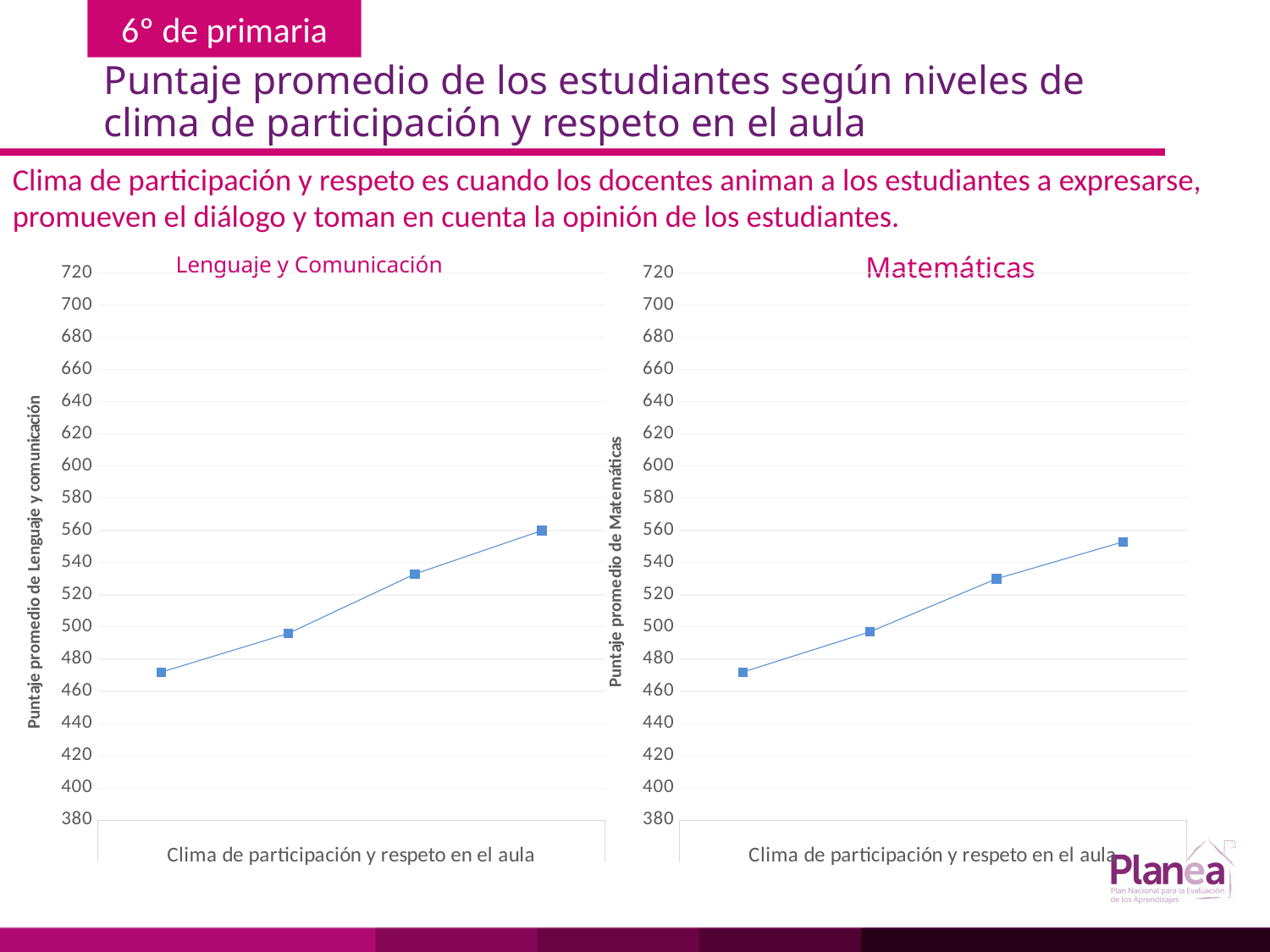
What is the y-axis title of the Lenguaje y Comunicación chart? Puntaje promedio de Lenguaje y comunicación How many data points are plotted on the Lenguaje y Comunicación chart? 4 On the Matemáticas chart, is the value of the leftmost point greater or less than 480? less What kind of chart is the Lenguaje y Comunicación chart? line chart How many data points are plotted on the Matemáticas chart? 4 On the Lenguaje y Comunicación chart, do the values rise or fall from left to right along the x axis? rise What kind of chart is the Matemáticas chart? line chart On the Lenguaje y Comunicación chart, is the value of the leftmost point greater or less than 480? less What is the x-axis label on the Matemáticas chart? Clima de participación y respeto en el aula On the Lenguaje y Comunicación chart, is the value of the rightmost point greater or less than 540? greater On the Matemáticas chart, do the values rise or fall from left to right along the x axis? rise